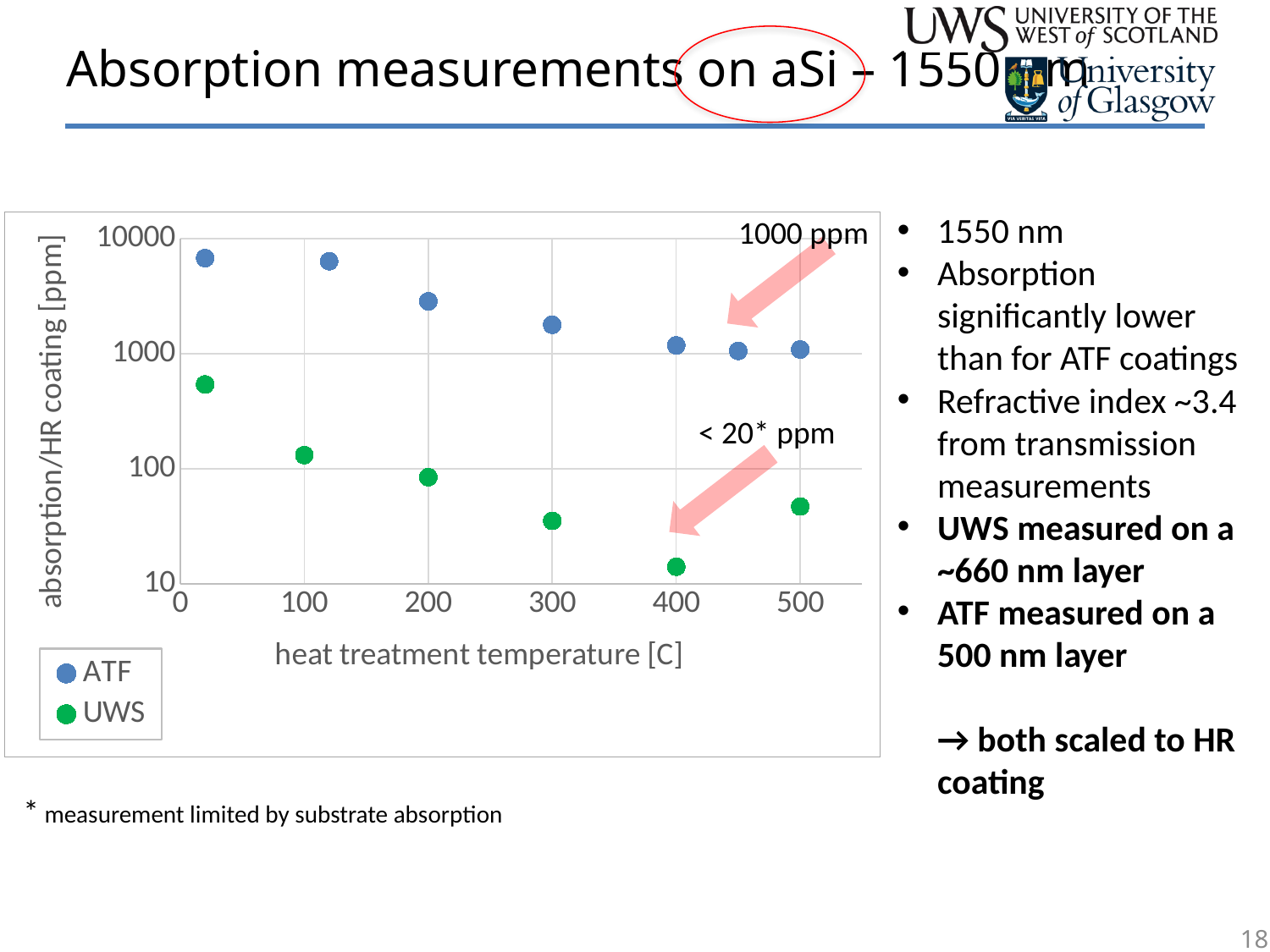
Is the ATF value at 200 C greater or less than 1000 ppm? greater How many UWS data points are plotted? 6 At 200 C, which series has the higher absorption, ATF or UWS? ATF How many ATF data points are plotted? 7 Is the UWS value at 400 C greater or less than 100 ppm? less Is the UWS value at 20 C greater or less than 1000 ppm? less At which heat treatment temperature is the UWS absorption lowest? 400 C What is the title of the x axis? heat treatment temperature [C] What kind of chart is shown on the slide? scatter chart How many series does the legend list? 2 What are the two series named in the legend? ATF and UWS Do the ATF absorption values rise or fall as heat treatment temperature increases? fall